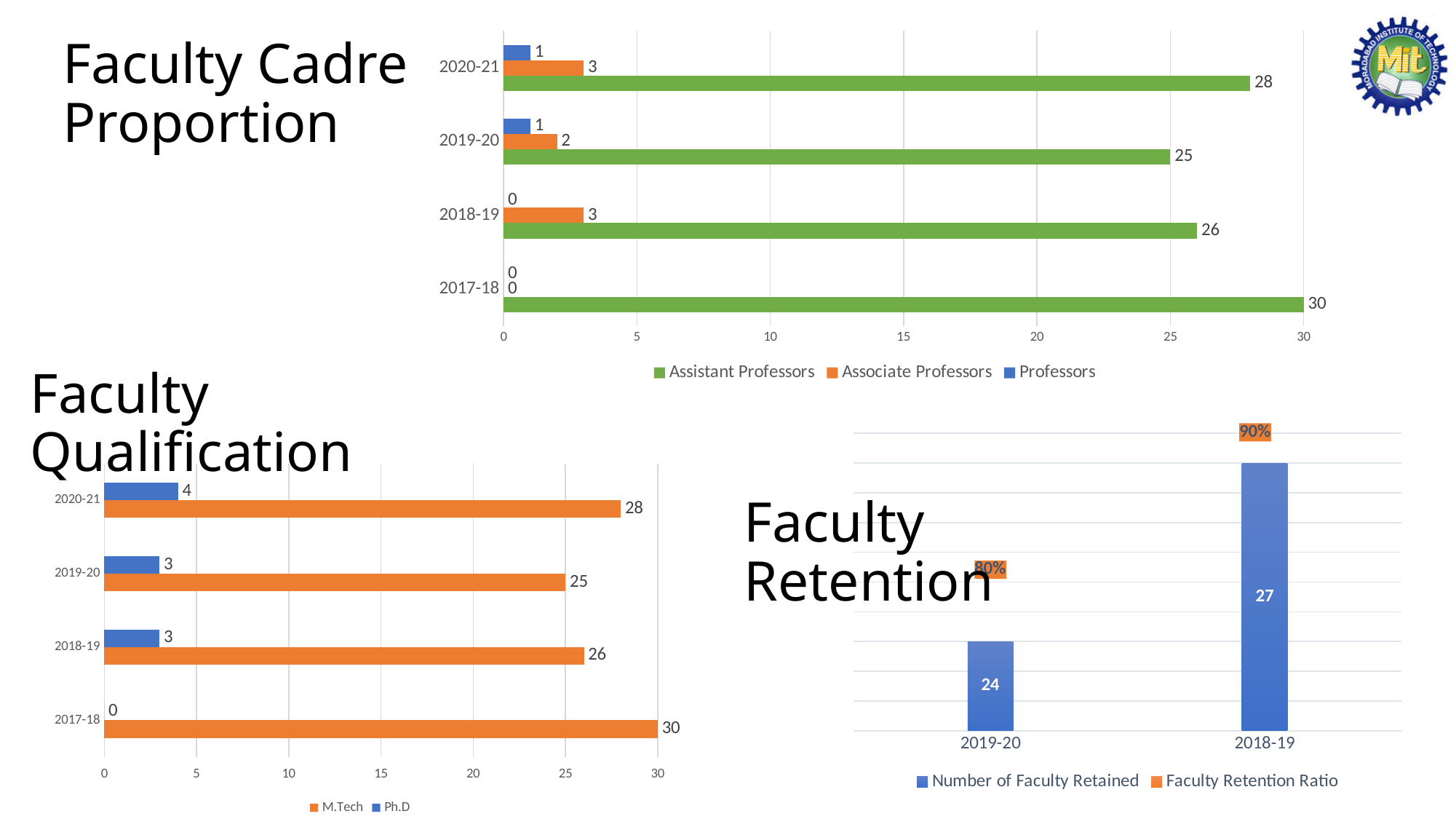
In the Faculty Cadre Proportion chart, how many Associate Professors were there in 2018-19? 3 In the Faculty Cadre Proportion chart, how many series does the legend list? 3 In the Faculty Qualification chart, how many Ph.D faculty were there in 2020-21? 4 In the Faculty Cadre Proportion chart, how many Assistant Professors were there in 2020-21? 28 In the Faculty Qualification chart, which year had the lowest number of Ph.D faculty? 2017-18 In the Faculty Qualification chart, how many years are shown on the axis? 4 In the Faculty Qualification chart, how many M.Tech faculty were there in 2019-20? 25 In the Faculty Retention chart, what was the Faculty Retention Ratio in 2018-19? 90% In the Faculty Cadre Proportion chart, what is the difference between Assistant Professors in 2017-18 and 2019-20? 5 In the Faculty Retention chart, what was the Number of Faculty Retained in 2018-19? 27 What kind of chart is the Faculty Retention chart? bar chart In the Faculty Cadre Proportion chart, which year had the highest number of Assistant Professors? 2017-18